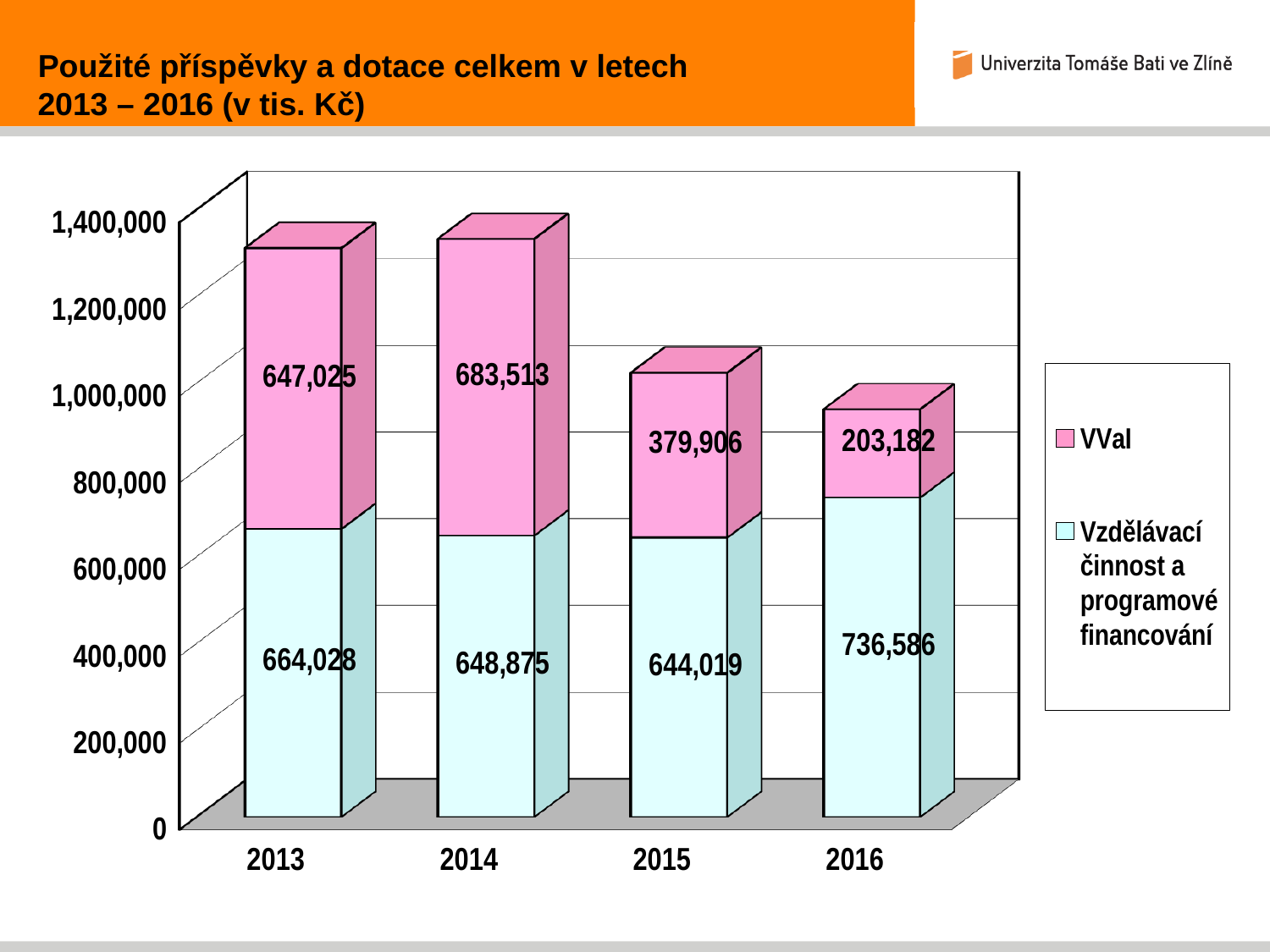
In which year is the value for Vzdělávací činnost a programové financování the highest? 2016 What is the difference between the VVaI values for 2015 and 2016? 176,724 In which year is the VVaI value the lowest? 2016 What is the value for Vzdělávací činnost a programové financování in 2016? 736,586 What is the VVaI value for 2014? 683,513 What is the difference between the VVaI values for 2014 and 2013? 36,488 How many years are shown on the x axis? 4 What is the VVaI value for 2016? 203,182 In which year is the VVaI value the highest? 2014 Which is larger: the VVaI value for 2013 or the VVaI value for 2015? 2013 What is the total of the stacked bar for 2016? 939,768 How many series does the legend list? 2